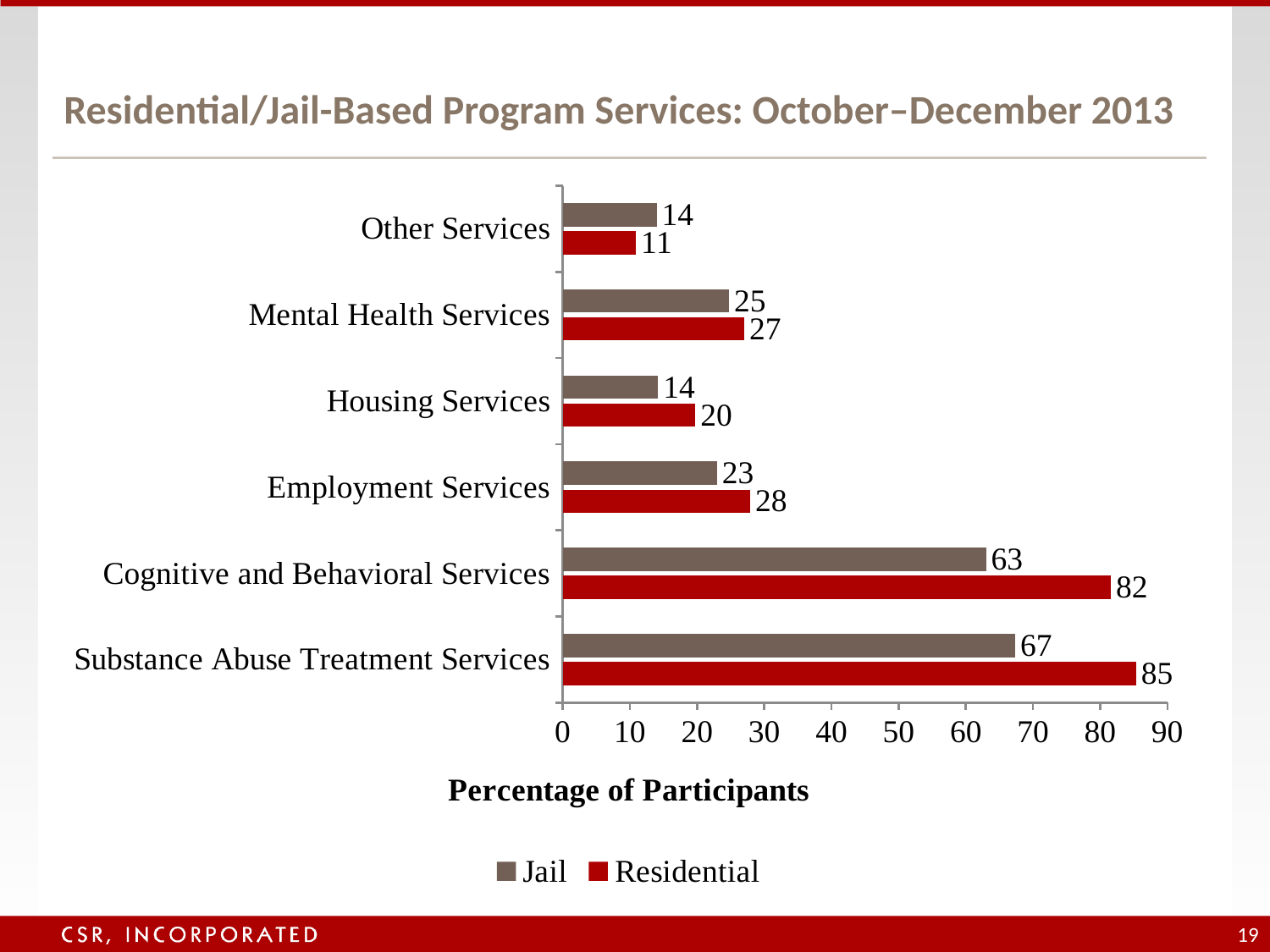
Which is larger for Mental Health Services, the Jail value or the Residential value? Residential Is the Jail value for Employment Services greater or less than 30? less Which category has the highest Jail value? Substance Abuse Treatment Services Which category has the lowest Residential value? Other Services What is the Residential value for Substance Abuse Treatment Services? 85 What is the Residential value for Housing Services? 20 What is the label of the horizontal axis? Percentage of Participants What kind of chart is shown on the slide? bar chart How many series does the legend list? 2 What is the Jail value for Cognitive and Behavioral Services? 63 How many service categories are shown on the chart? 6 What is the difference between the Residential and Jail values for Cognitive and Behavioral Services? 19